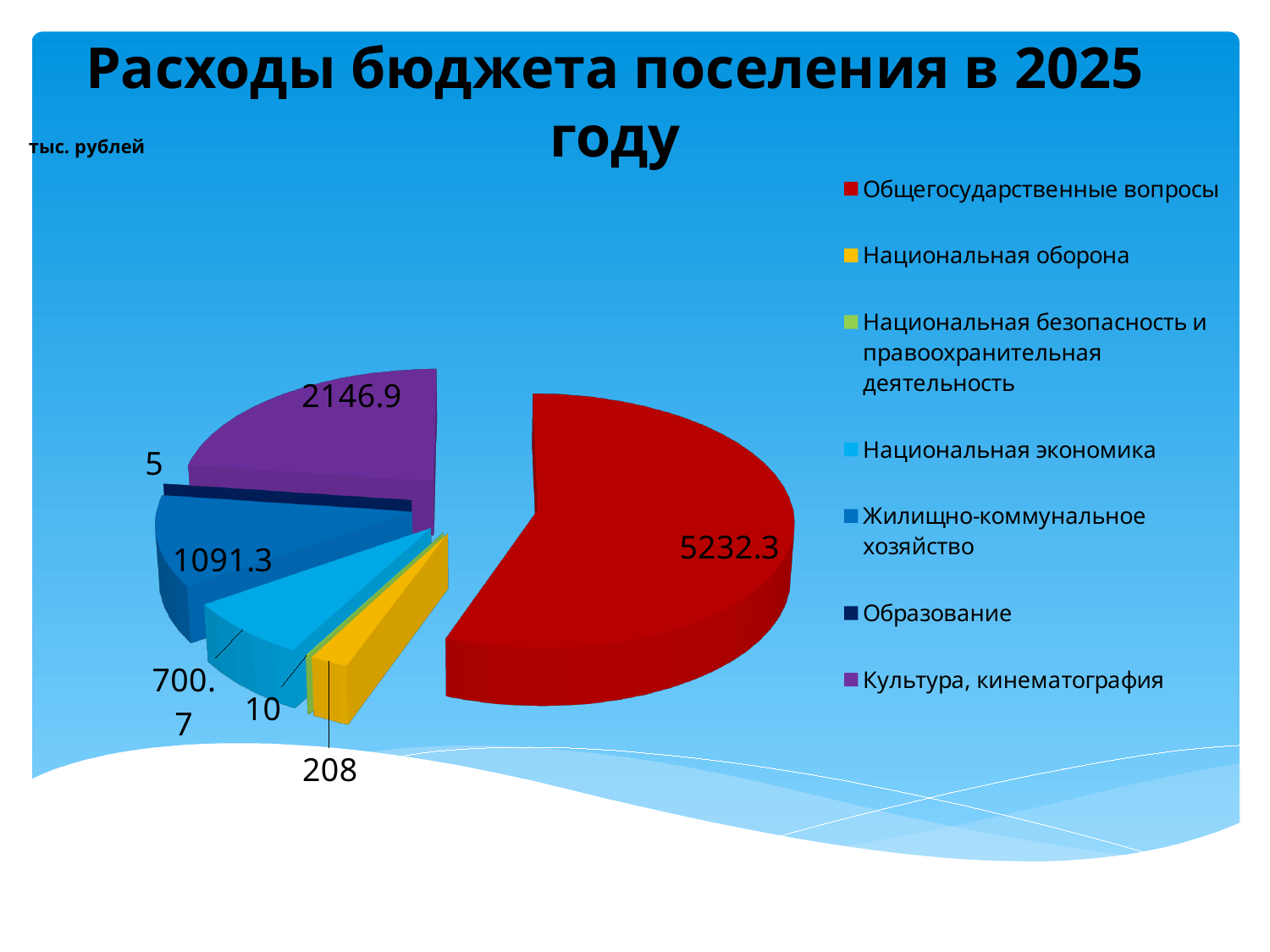
What is the value for Общегосударственные вопросы? 5232.3 Which category has the smallest value? Образование Which is larger: Жилищно-коммунальное хозяйство or Национальная экономика? Жилищно-коммунальное хозяйство How many categories does the pie chart have? 7 What is the value for Национальная оборона? 208 What is the value for Образование? 5 What is the value for Культура, кинематография? 2146.9 What is the difference between Общегосударственные вопросы and Культура, кинематография? 3085.4 What unit is indicated in the top-left corner of the chart? тыс. рублей Which category has the largest slice? Общегосударственные вопросы What is the value for Жилищно-коммунальное хозяйство? 1091.3 What type of chart is shown on the slide? pie chart